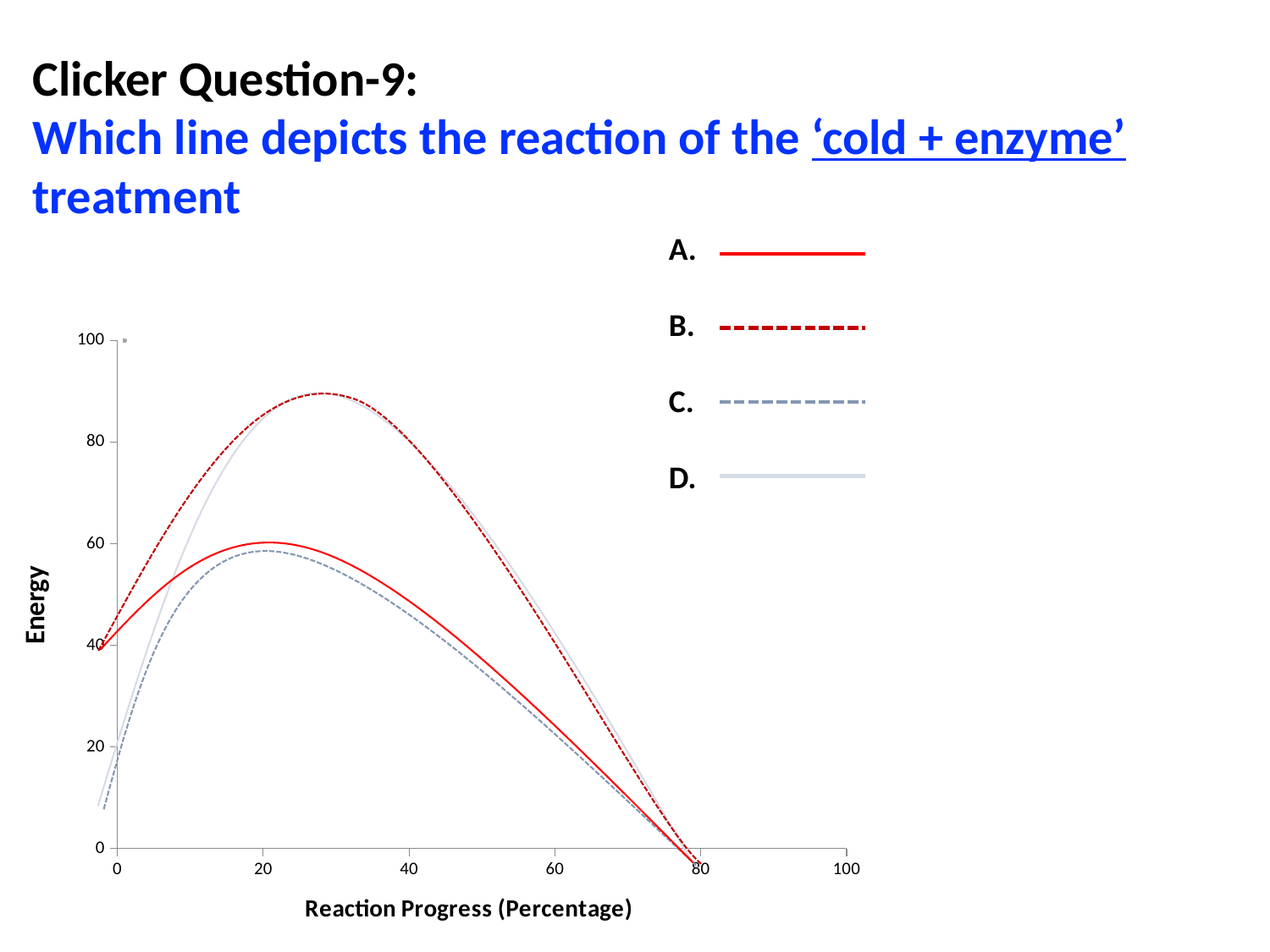
Between 40% and 80% reaction progress, do the energy values of the lines rise or fall? fall Is the energy of line A at 60% reaction progress greater or less than 40? less Which reaches a higher peak energy, line A or line B? line B Is the peak energy of line A greater or less than 80? less How many lines (options A–D) are plotted on the chart? 4 What is the title of the y axis? Energy What is the title of the x axis? Reaction Progress (Percentage) Is the peak energy of line B greater or less than 80? greater What kind of chart is shown on the slide? line chart At what reaction progress percentage do all four lines reach an energy of 0? 80